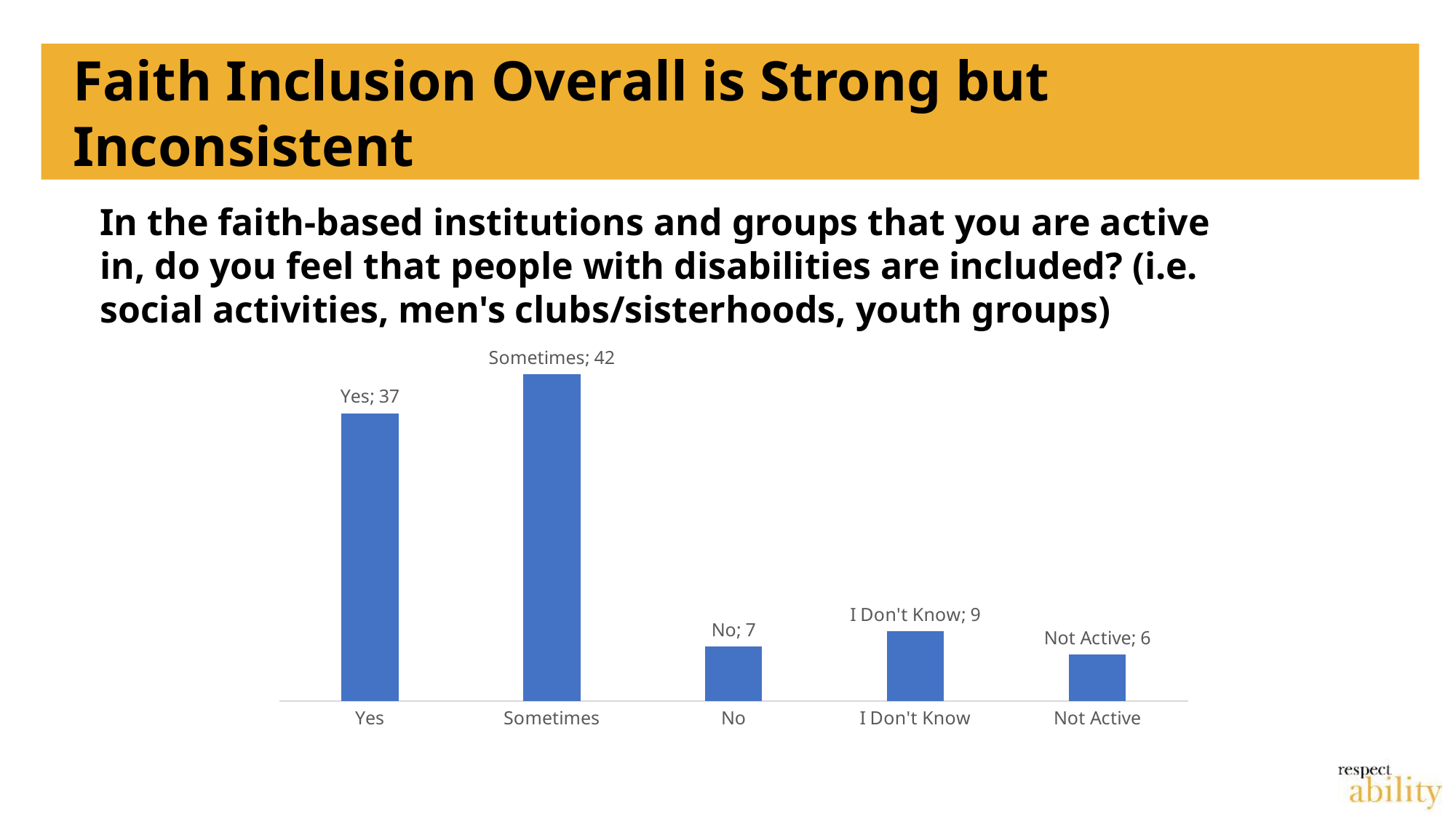
What is the value for Sometimes? 42 Which category has the lowest value? Not Active What is the difference between the values for Sometimes and Yes? 5 How many categories are shown on the x axis? 5 What is the value for No? 7 What kind of chart is shown on the slide? Bar chart What is the value for Not Active? 6 Which category has the highest value? Sometimes What is the total of the values for No, I Don't Know and Not Active? 22 What is the value for Yes? 37 Which is larger, the value for No or the value for I Don't Know? I Don't Know What is the value for I Don't Know? 9